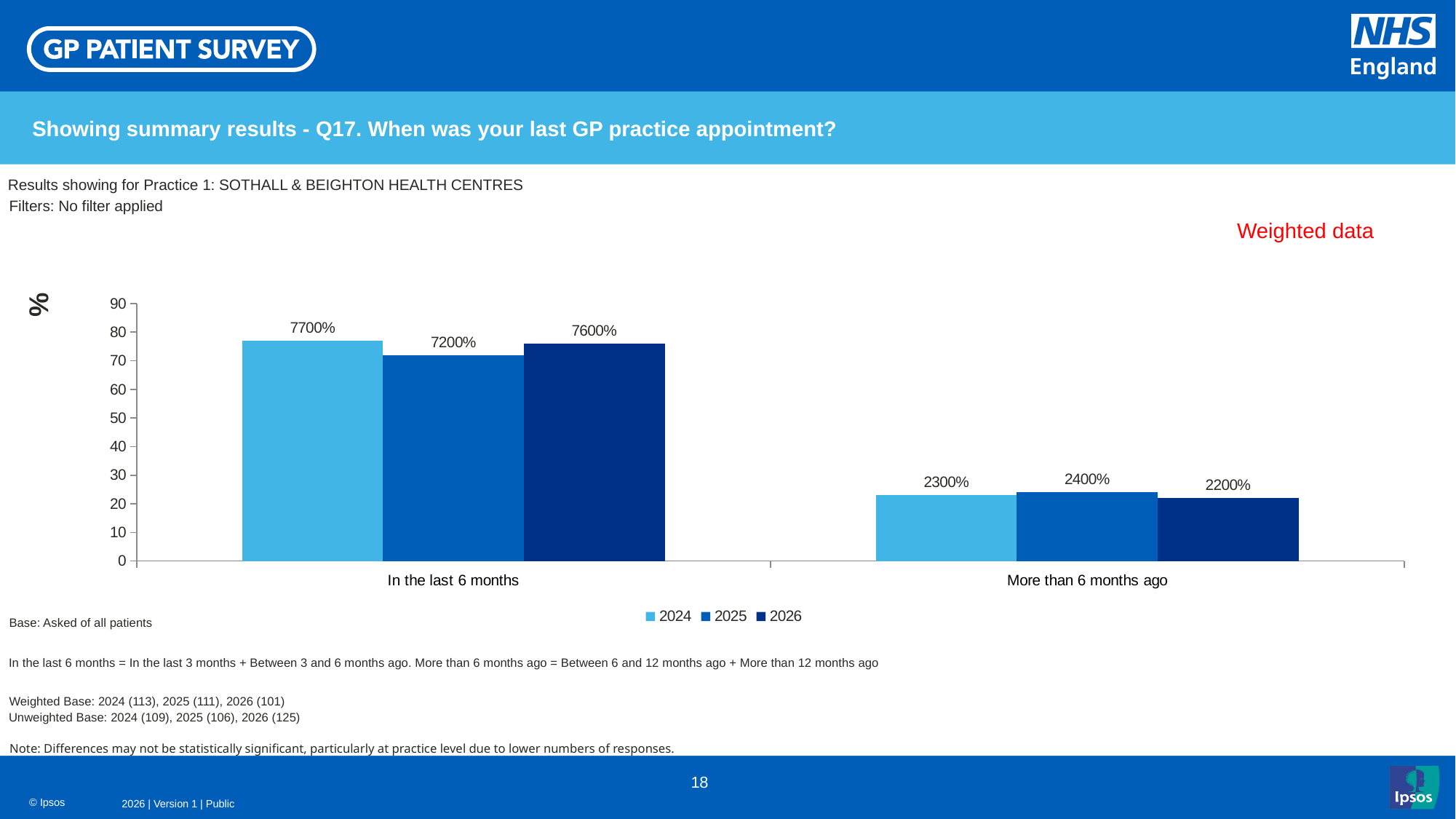
What kind of chart is shown on the slide? Bar chart What is the data label for 2024 in the 'In the last 6 months' category? 7700% What is the data label for 2026 in the 'More than 6 months ago' category? 2200% How many series does the legend list? 3 Which year has the lowest value in the 'More than 6 months ago' category? 2026 What is the data label for 2025 in the 'More than 6 months ago' category? 2400% How many categories are shown on the x axis? 2 Is the 2024 bar for 'More than 6 months ago' greater or less than 30 on the axis? less What is the data label for 2025 in the 'In the last 6 months' category? 7200% Is the 2025 bar for 'In the last 6 months' greater or less than 70 on the axis? greater Which is larger for 2026: the 'In the last 6 months' value or the 'More than 6 months ago' value? In the last 6 months Which year has the highest value in the 'In the last 6 months' category? 2024